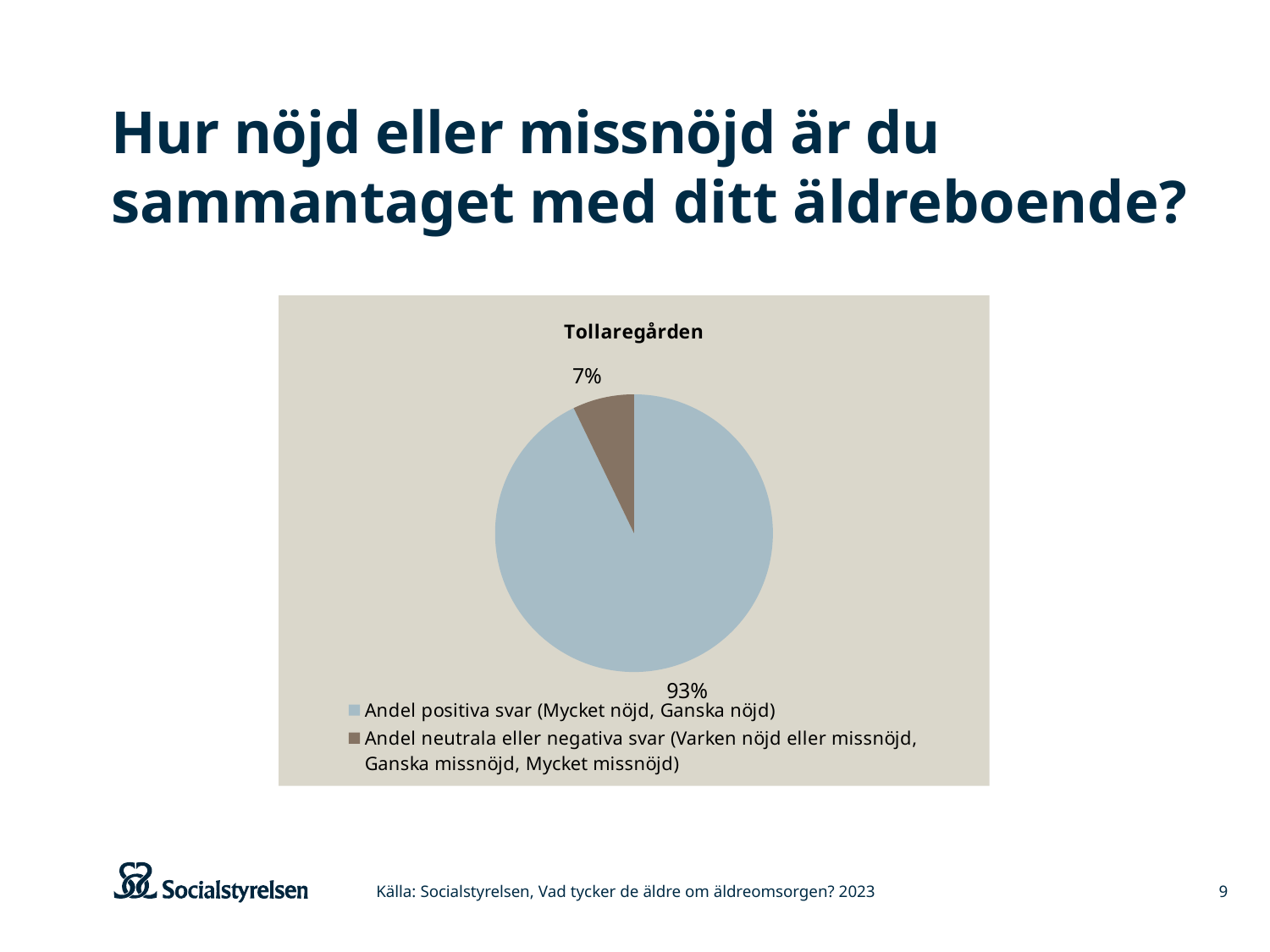
Which slice of the pie is the smallest? Andel neutrala eller negativa svar (Varken nöjd eller missnöjd, Ganska missnöjd, Mycket missnöjd) What colour is the slice for 'Andel positiva svar (Mycket nöjd, Ganska nöjd)'? light blue What share of the pie is 'Andel positiva svar (Mycket nöjd, Ganska nöjd)'? 93% What kind of chart is shown on the slide? pie chart Which is larger: the share of positive answers or the share of neutral or negative answers? Andel positiva svar (Mycket nöjd, Ganska nöjd) Which slice of the pie is the largest? Andel positiva svar (Mycket nöjd, Ganska nöjd) What is the title of the chart? Tollaregården How many entries does the legend list? 2 What is the difference in percentage points between the positive slice and the neutral or negative slice? 86 percentage points What share of the pie is 'Andel neutrala eller negativa svar (Varken nöjd eller missnöjd, Ganska missnöjd, Mycket missnöjd)'? 7% How many slices does the pie chart have? 2